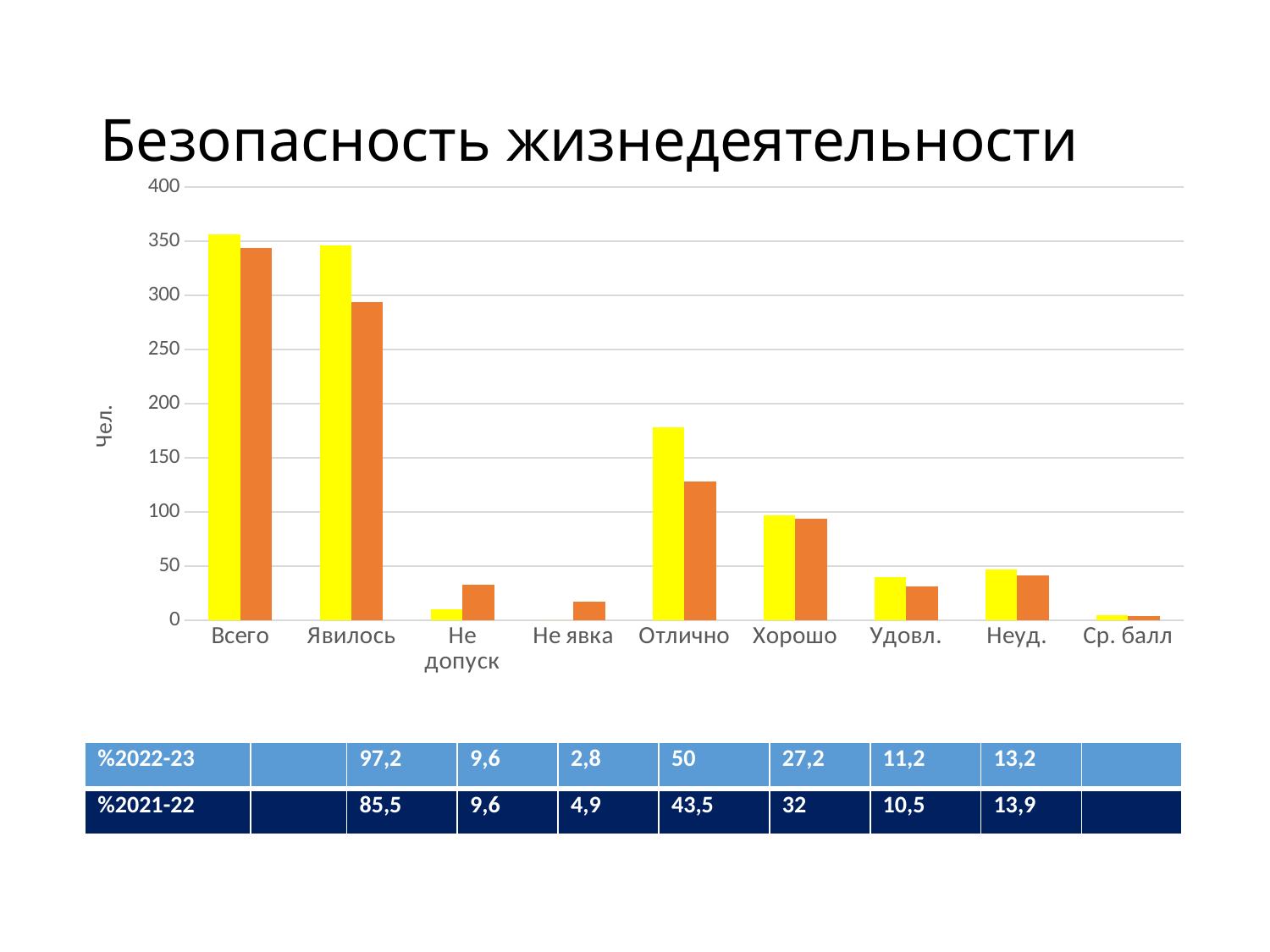
What is the title of the slide with the chart? Безопасность жизнедеятельности Which category has the shortest orange bar? Ср. балл Is the yellow bar for Всего greater or less than 300? greater What is the label on the vertical axis of the chart? Чел. What kind of chart is shown on the slide? bar chart Is the orange bar for Не допуск greater or less than 50? less Is the orange bar for Явилось greater or less than 250? greater Which category has the tallest yellow bar? Всего How many bars are plotted for each category in the chart? 2 How many categories are shown along the x axis of the chart? 9 For the category Явилось, which bar is taller, the yellow one or the orange one? yellow